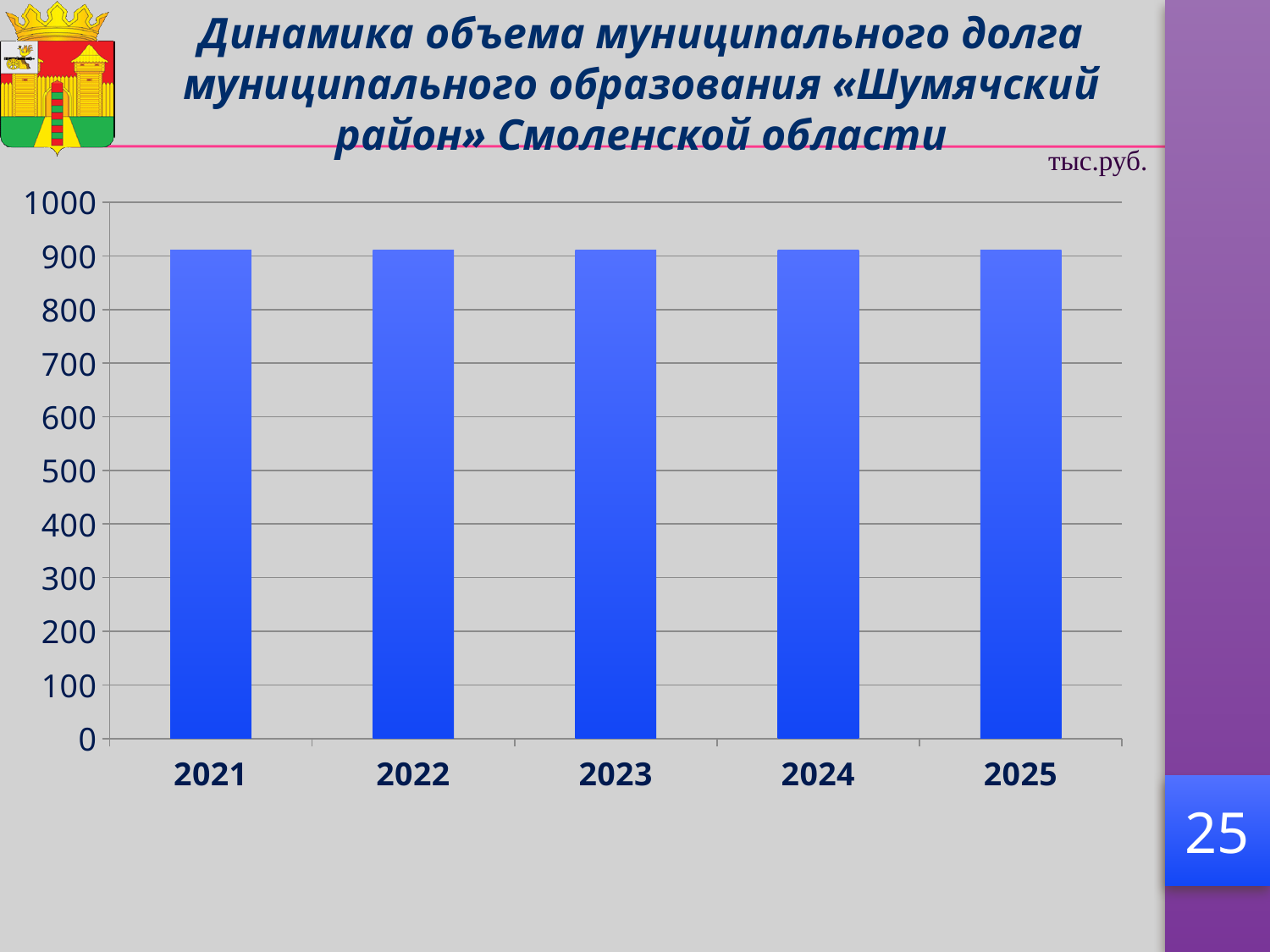
Is the value for 2021 greater or less than 800? greater Is the value for 2024 greater or less than 1000? less What kind of chart is shown on the slide? bar chart Is the value for 2025 greater or less than 500? greater How many years (bars) are shown on the chart? 5 What is the first year shown on the x axis? 2021 Do the values rise, fall, or stay roughly the same from 2021 to 2025? stay roughly the same What unit of measurement is indicated above the chart? тыс.руб.